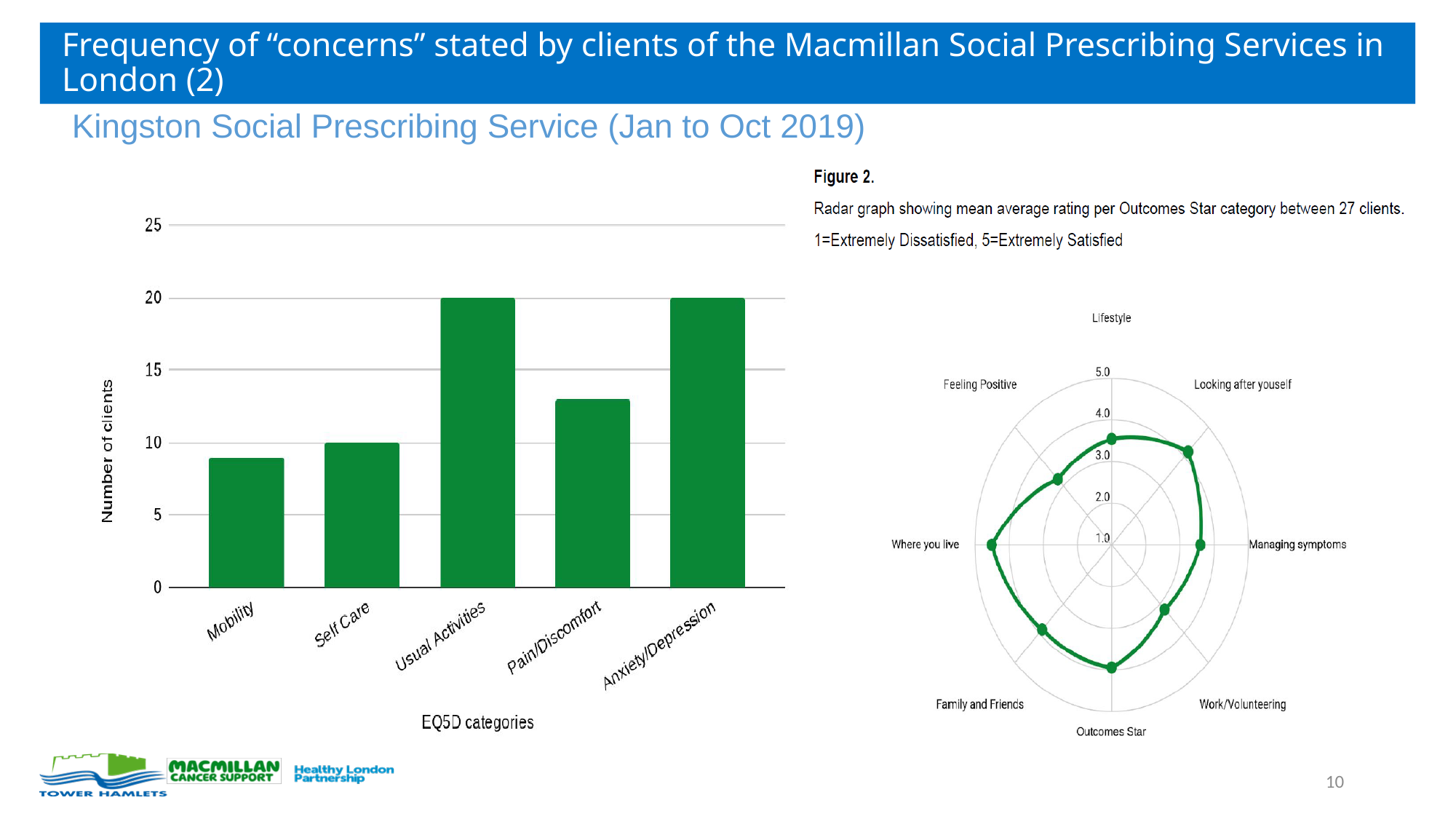
In the bar chart on the left, is the value for Pain/Discomfort greater or less than 15? less In the bar chart on the left, what is the label of the vertical axis? Number of clients In the bar chart on the left, what is the number of clients for Usual Activities? 20 In the bar chart on the left, is the value for Mobility greater or less than 10? less In the bar chart on the left, what is the number of clients for Self Care? 10 What kind of chart is the chart on the left of the slide (EQ5D categories)? bar chart In the bar chart on the left, how many EQ5D categories are shown? 5 In the bar chart on the left, what is the number of clients for Anxiety/Depression? 20 In the bar chart on the left, which has more clients, Usual Activities or Pain/Discomfort? Usual Activities In the radar chart on the right (Figure 2), how many Outcomes Star categories are plotted? 8 What kind of chart is Figure 2 on the right of the slide? radar chart In the bar chart on the left, what is the difference in number of clients between Usual Activities and Self Care? 10